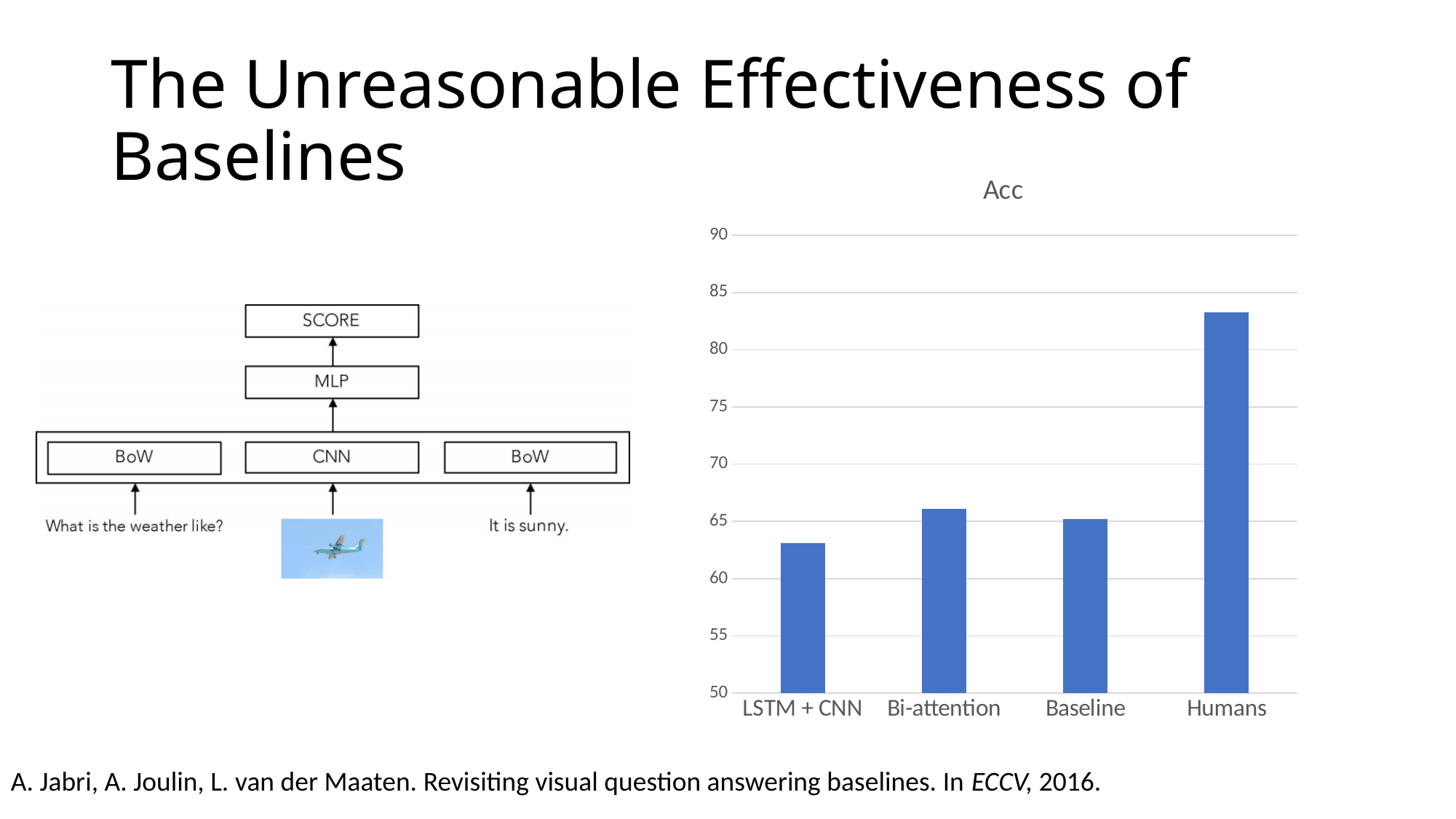
Which category has the lowest value in the chart? LSTM + CNN Which is larger, the value for Bi-attention or the value for LSTM + CNN? Bi-attention Is the value for Humans greater or less than 85? less How many categories are shown on the x axis of the chart? 4 Is the value for LSTM + CNN greater or less than 60? greater Which is larger, the value for Humans or the value for Baseline? Humans What is the title of the chart? Acc What kind of chart is shown on the slide? bar chart Is the value for Baseline greater or less than 70? less Which category has the highest value in the chart? Humans